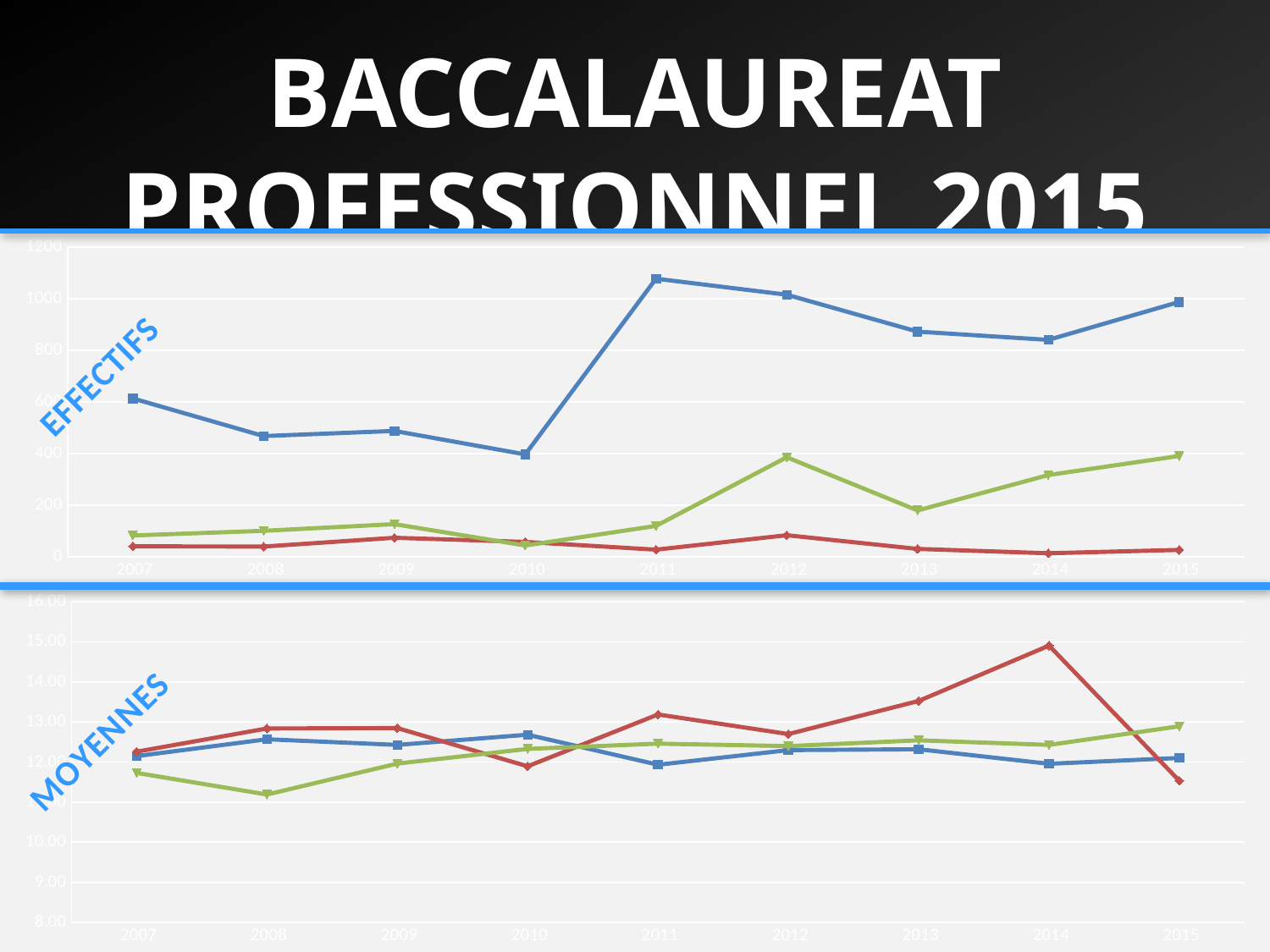
In the bottom chart (MOYENNES), in which year does the red line reach its highest value? 2014 In the top chart (EFFECTIFS), which line is higher in 2011, the blue line or the green line? the blue line In the bottom chart (MOYENNES), is the red line's value for 2014 greater or less than 14.00? greater In the bottom chart (MOYENNES), does the red line rise or fall from 2014 to 2015? fall What is the label written beside the bottom chart? MOYENNES How many years are shown on the x axis of the top chart (EFFECTIFS)? 9 In the top chart (EFFECTIFS), is the blue line's value for 2011 greater or less than 1000? greater What kind of chart is the top chart labelled EFFECTIFS? line chart In the top chart (EFFECTIFS), in which year is the blue line at its lowest? 2010 In the top chart (EFFECTIFS), in which year does the blue line reach its highest value? 2011 In the top chart (EFFECTIFS), is the red line's value for 2015 greater or less than 200? less How many lines are plotted in the bottom chart (MOYENNES)? 3